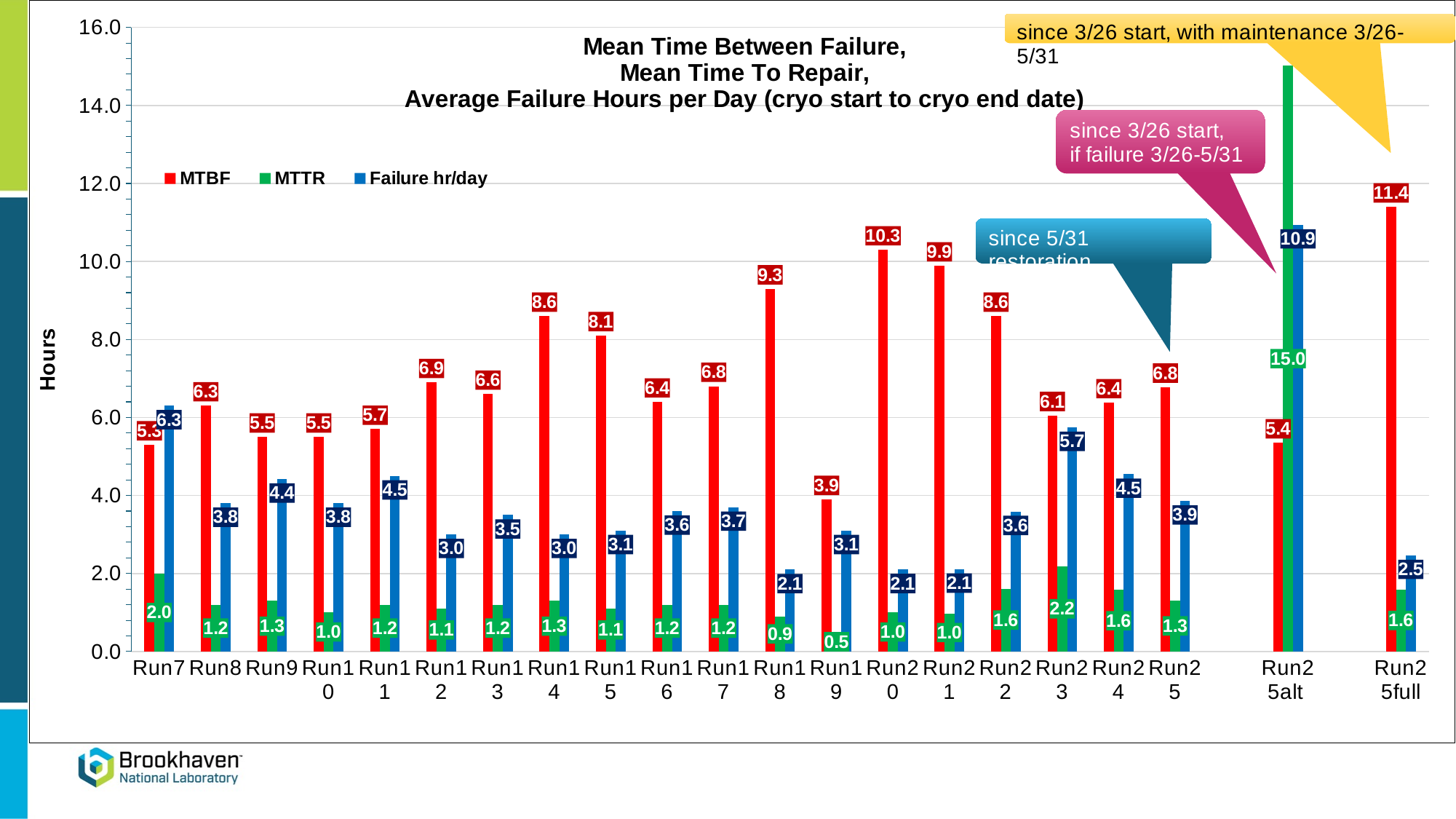
What is the MTBF value for Run20? 10.3 What is the label of the y axis? Hours Which run has the lowest MTTR value? Run19 Which is larger, the Failure hr/day value for Run7 or for Run8? Run7 What is the MTTR value for Run25alt? 15.0 What type of chart is shown on the slide? bar chart How many run categories are shown on the x axis? 21 Which run has the highest MTBF value? Run25full What is the difference between the MTBF values for Run25full and Run25alt? 6.0 What is the Failure hr/day value for Run23? 5.7 Which run has the lowest MTBF value? Run19 How many series does the legend list? 3